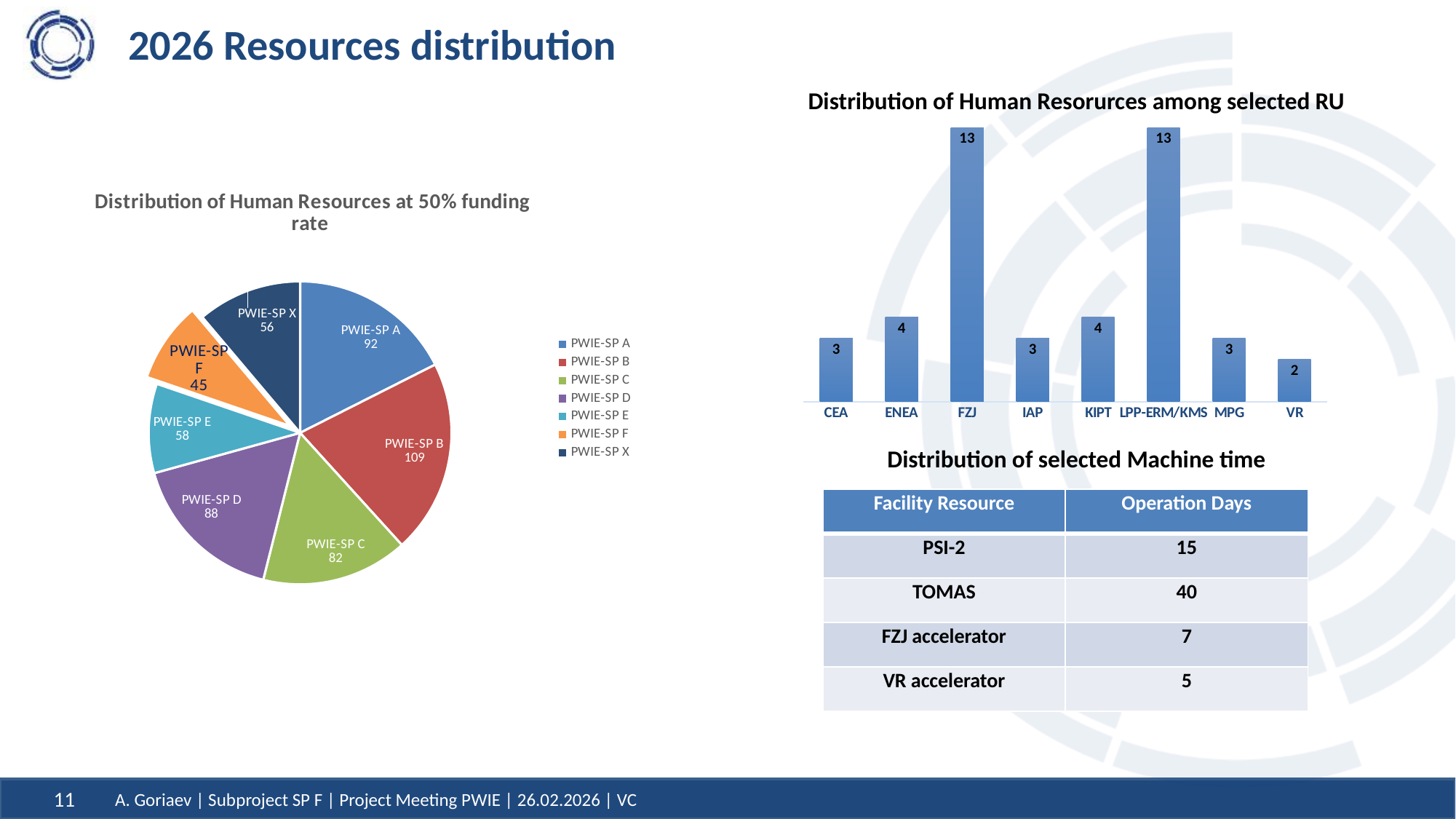
In the bar chart 'Distribution of Human Resorurces among selected RU', what is the value for LPP-ERM/KMS? 13 In the bar chart 'Distribution of Human Resorurces among selected RU', what is the value for KIPT? 4 In the bar chart 'Distribution of Human Resorurces among selected RU', which RU has the lowest value? VR In the pie chart 'Distribution of Human Resources at 50% funding rate', which category has the largest value? PWIE-SP B In the pie chart 'Distribution of Human Resources at 50% funding rate', what is the value for PWIE-SP X? 56 In the bar chart 'Distribution of Human Resorurces among selected RU', which is larger, ENEA or MPG? ENEA In the pie chart 'Distribution of Human Resources at 50% funding rate', what is the difference between PWIE-SP A and PWIE-SP C? 10 In the pie chart 'Distribution of Human Resources at 50% funding rate', what is the value for PWIE-SP B? 109 What kind of chart is 'Distribution of Human Resorurces among selected RU'? bar chart In the bar chart 'Distribution of Human Resorurces among selected RU', what is the difference between FZJ and CEA? 10 In the pie chart 'Distribution of Human Resources at 50% funding rate', how many categories are shown? 7 In the pie chart 'Distribution of Human Resources at 50% funding rate', which category has the smallest value? PWIE-SP F